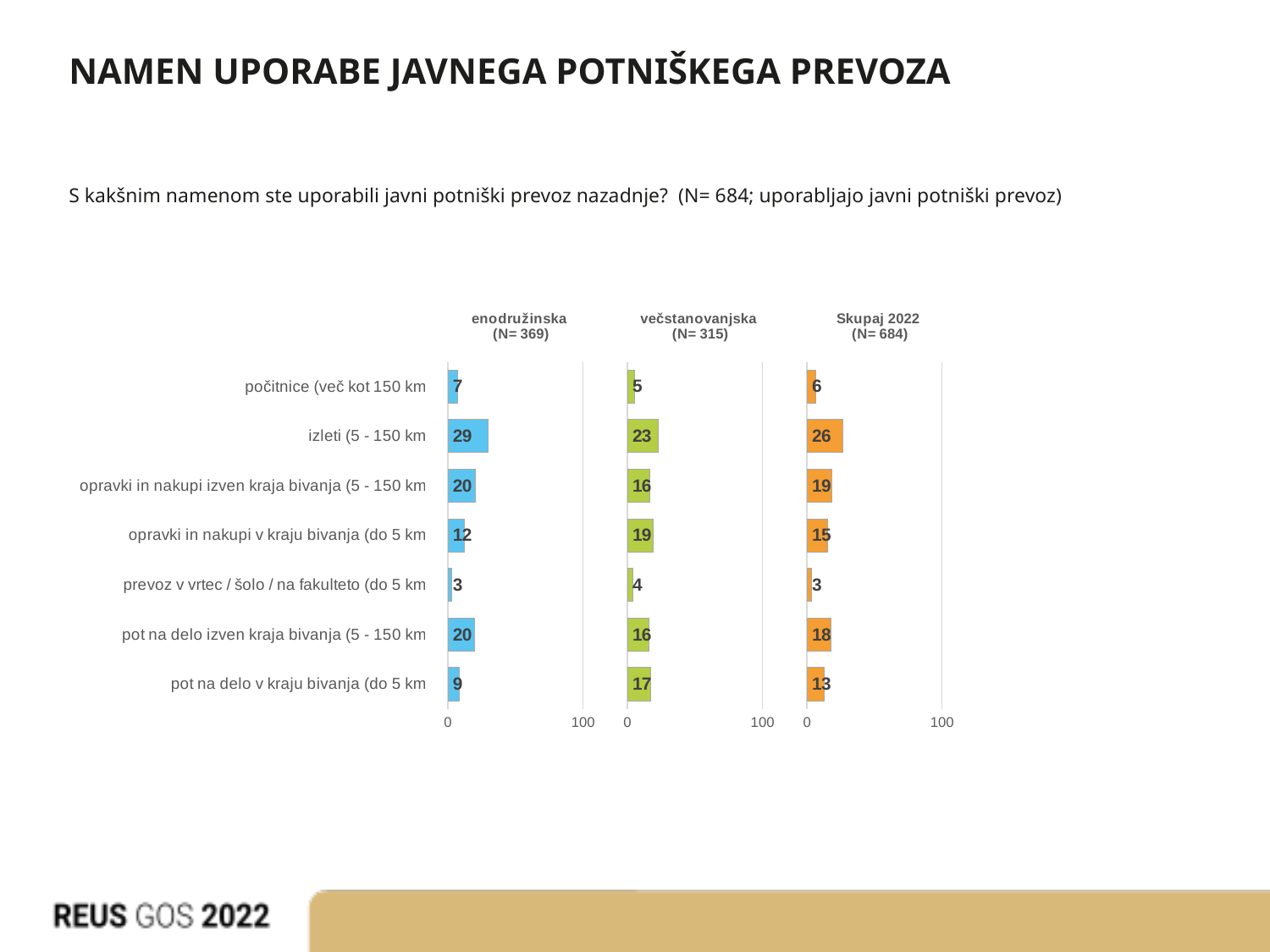
In the 'enodružinska (N= 369)' chart, which category has the lowest value? prevoz v vrtec / šolo / na fakulteto (do 5 km In the 'Skupaj 2022 (N= 684)' chart, what is the value for 'opravki in nakupi izven kraja bivanja (5 - 150 km'? 19 In the 'enodružinska (N= 369)' chart, which is larger: the value for 'opravki in nakupi v kraju bivanja (do 5 km' or 'pot na delo v kraju bivanja (do 5 km'? opravki in nakupi v kraju bivanja (do 5 km What kind of chart is the 'Skupaj 2022 (N= 684)' chart? bar chart In the 'Skupaj 2022 (N= 684)' chart, which category has the highest value? izleti (5 - 150 km How many categories are shown in the 'enodružinska (N= 369)' chart? 7 In the 'večstanovanjska (N= 315)' chart, what is the difference between the values for 'izleti (5 - 150 km' and 'počitnice (več kot 150 km'? 18 In the 'Skupaj 2022 (N= 684)' chart, is the value for 'izleti (5 - 150 km' greater or less than 100? less What colour are the bars in the 'večstanovanjska (N= 315)' chart? green In the 'enodružinska (N= 369)' chart, what is the value for 'izleti (5 - 150 km'? 29 In the 'večstanovanjska (N= 315)' chart, what is the value for 'pot na delo v kraju bivanja (do 5 km'? 17 How many separate charts are shown on the slide? 3